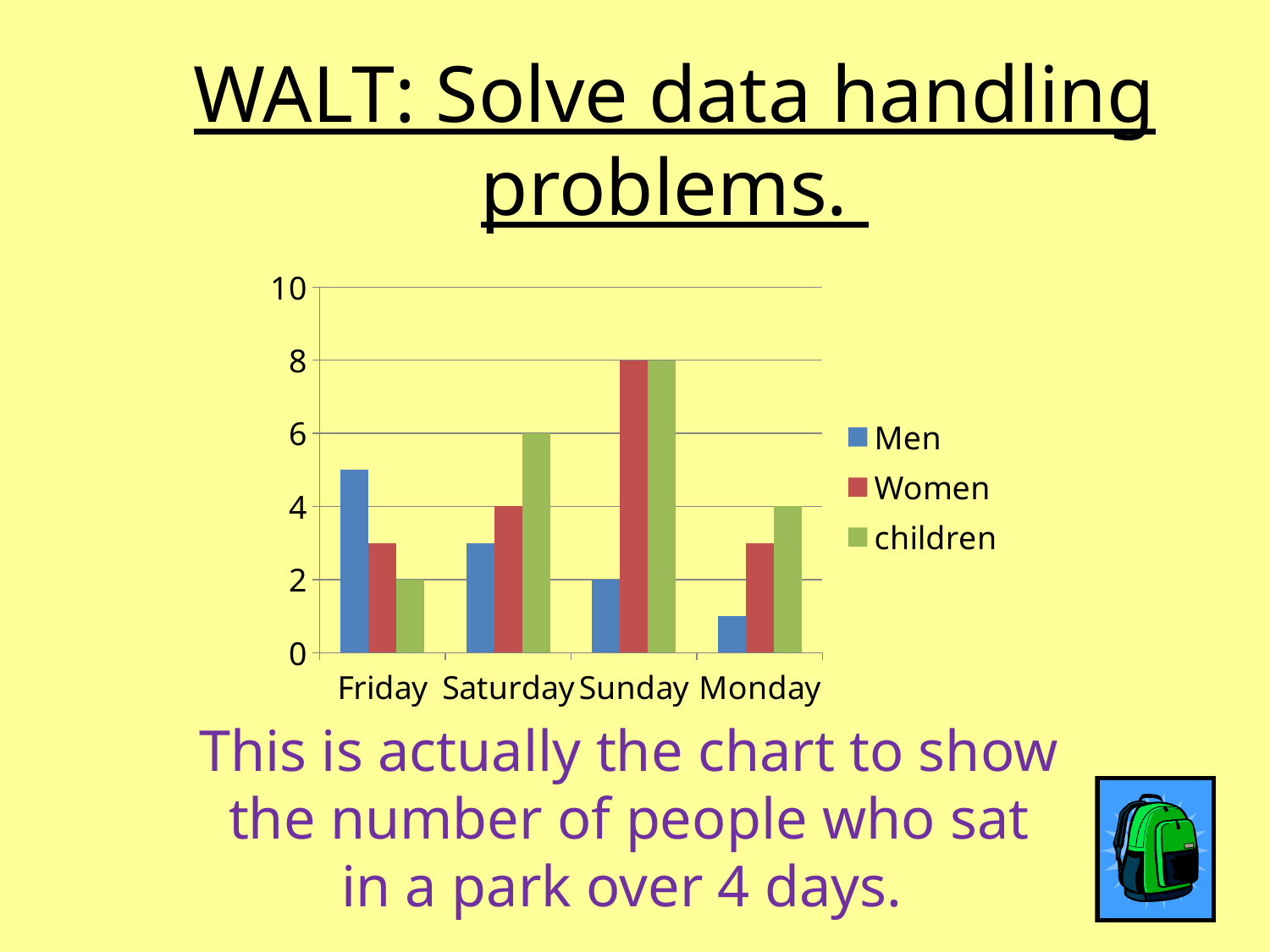
On which day is the Men bar lowest? Monday How many series does the legend list? 3 What is the value for Men on Sunday? 2 What is the difference between the Women and Men values on Sunday? 6 What is the value for Women on Saturday? 4 What is the value for children on Sunday? 8 On Saturday, which is larger: the value for Men or the value for children? children How many days are shown on the x axis? 4 What kind of chart is shown on the slide? bar chart On which day is the Men bar highest? Friday Do the Men values rise or fall from Friday to Monday? fall Is the value for Men on Friday greater or less than 4? greater